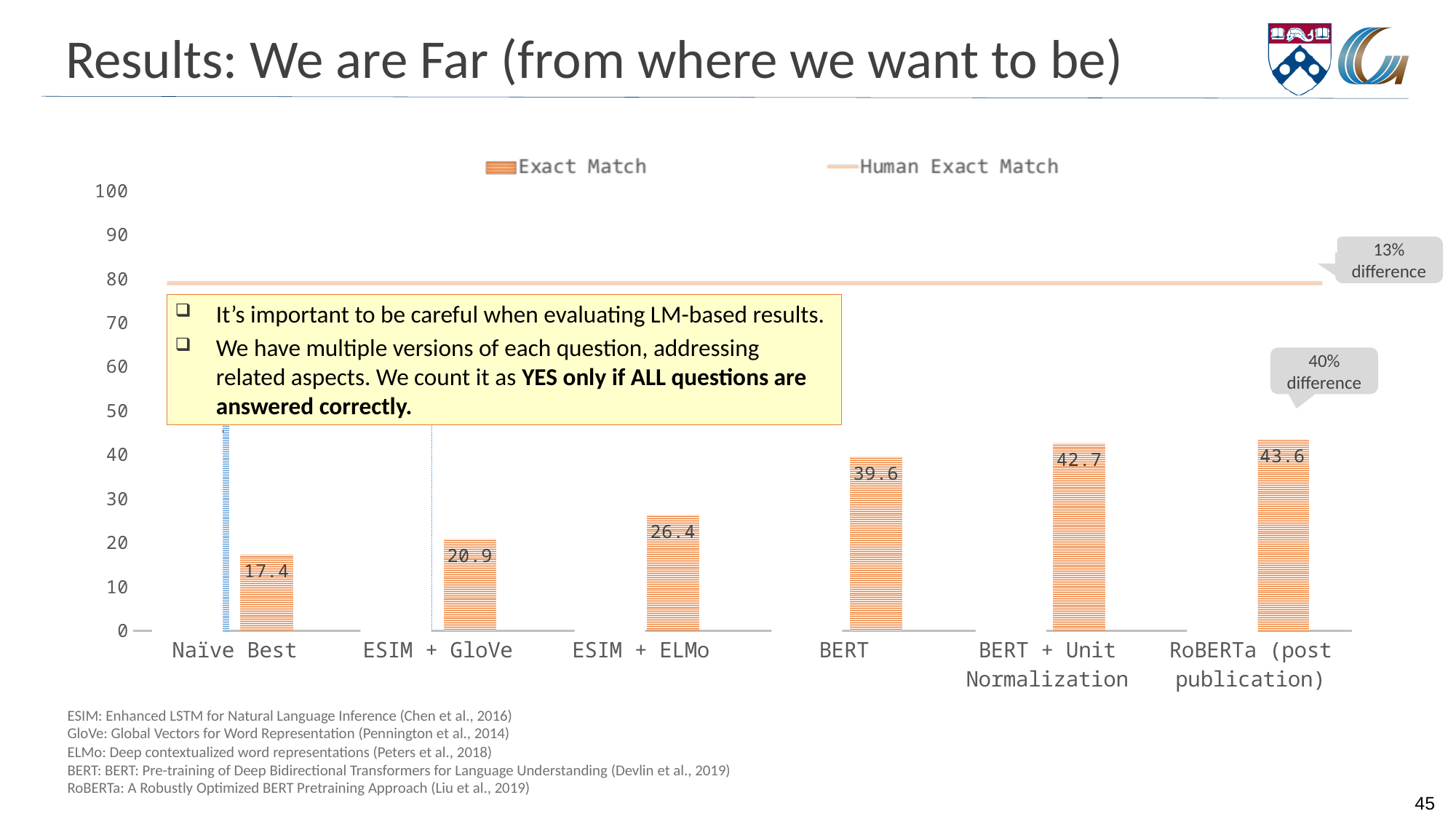
What is the difference between the Exact Match values for BERT + Unit Normalization and BERT? 3.1 Which category has the highest Exact Match value? RoBERTa (post publication) Which has a larger Exact Match value, ESIM + GloVe or ESIM + ELMo? ESIM + ELMo Do the Exact Match values rise or fall from left to right along the x axis? Rise What kind of chart is shown on the slide? Bar chart How many series does the chart legend list? 2 Is the Human Exact Match line greater or less than 70? greater What is the Exact Match value for Naïve Best? 17.4 What is the Exact Match value for BERT? 39.6 Which category has the lowest Exact Match value? Naïve Best How many categories are shown on the x axis of the chart? 6 What is the Exact Match value for ESIM + ELMo? 26.4